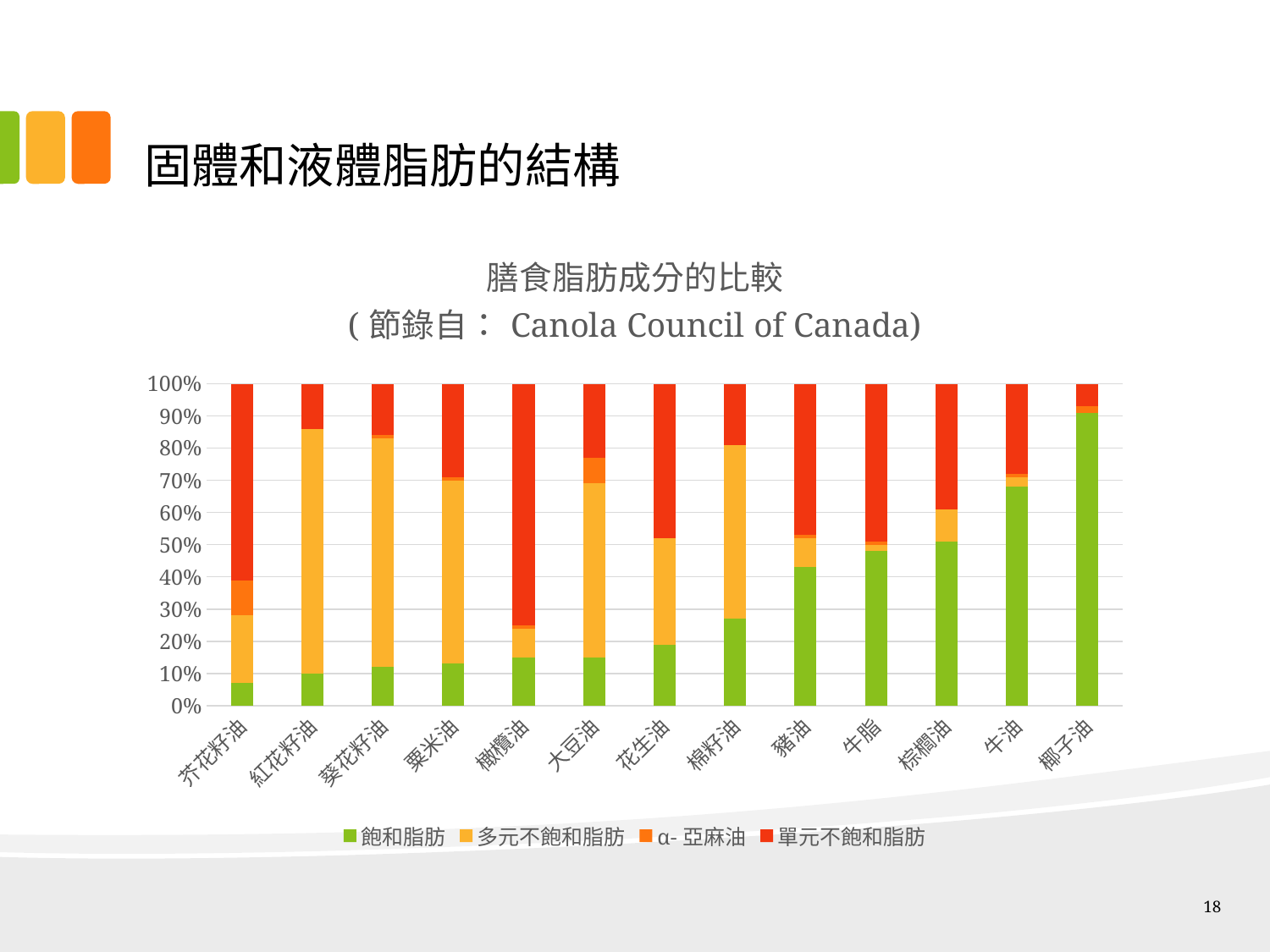
What kind of chart is shown on the slide? stacked bar chart How many series does the chart legend list? 4 Which category has the smallest 飽和脂肪 (green) share? 芥花籽油 Which has a larger 單元不飽和脂肪 share, 橄欖油 or 大豆油? 橄欖油 Does the 飽和脂肪 share generally rise or fall moving from left to right along the x axis? rise Which category has the largest 單元不飽和脂肪 (red) share? 橄欖油 Which category has the largest 飽和脂肪 (green) share? 椰子油 Is the 飽和脂肪 share for 豬油 greater or less than 50%? less Is the 飽和脂肪 share for 椰子油 greater or less than 80%? greater How many oil/fat categories are shown on the x axis of the chart? 13 Which has a larger 飽和脂肪 share, 牛油 or 椰子油? 椰子油 What is the source cited in the chart title? Canola Council of Canada